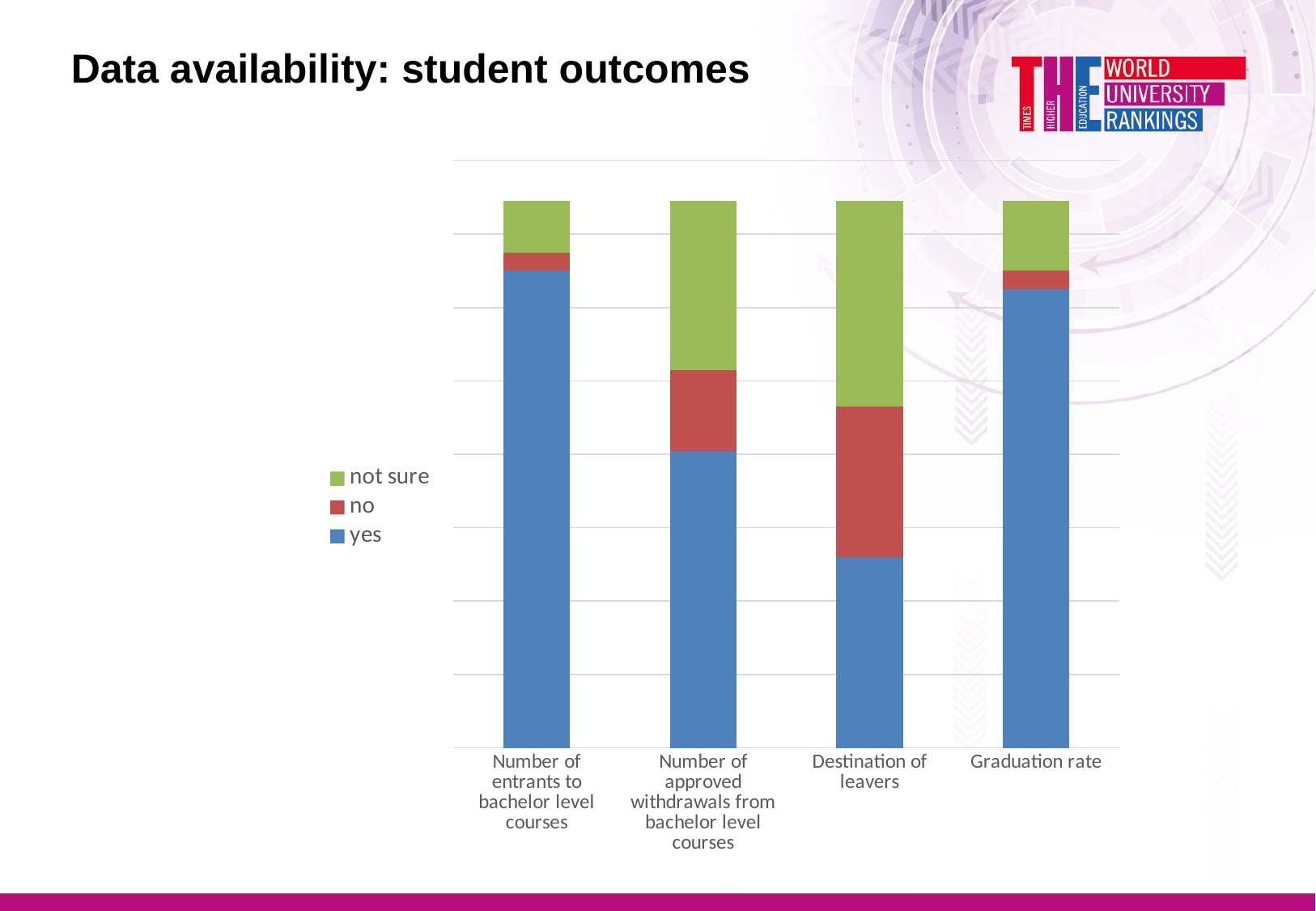
Which category has the smallest 'yes' segment? Destination of leavers How many categories are shown along the x axis of the chart? 4 Is the 'not sure' segment larger for Number of entrants to bachelor level courses or for Number of approved withdrawals from bachelor level courses? Number of approved withdrawals from bachelor level courses What is the title of the slide containing the chart? Data availability: student outcomes How many series does the chart's legend list? 3 Which colour represents the 'no' series in the chart? Red Which category has the largest 'not sure' segment? Destination of leavers What kind of chart is shown on the slide? Stacked bar chart Which category has the largest 'no' segment? Destination of leavers Is the 'yes' segment larger for Graduation rate or for Number of approved withdrawals from bachelor level courses? Graduation rate Which category has the largest 'yes' segment? Number of entrants to bachelor level courses